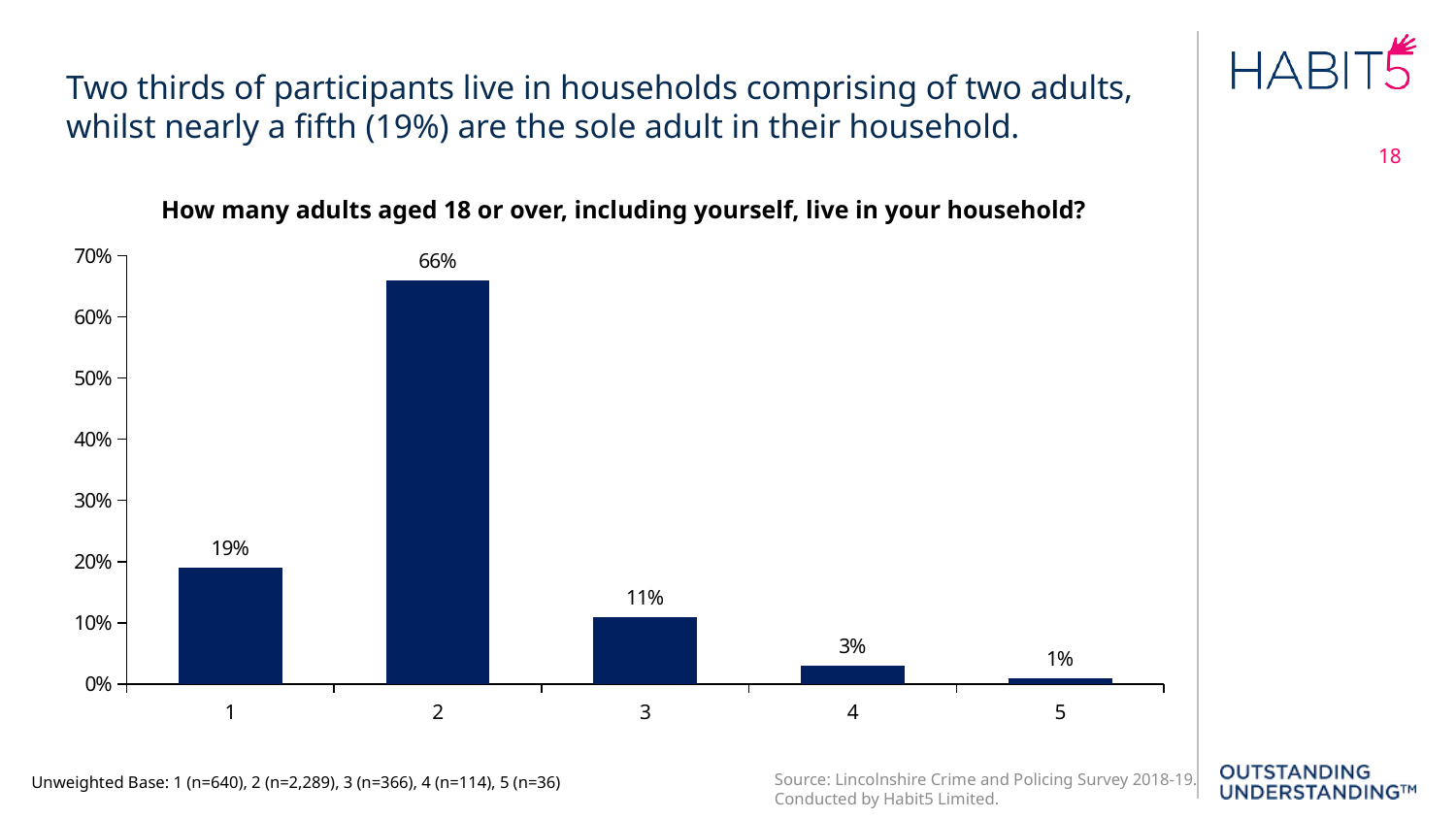
What percentage of participants live in a household with 2 adults? 66% What is the value shown for households with 5 adults? 1% What is the title of the chart? How many adults aged 18 or over, including yourself, live in your household? Which number of adults has the lowest percentage of participants? 5 What is the difference in percentage points between households with 2 adults and households with 1 adult? 47 Which number of adults has the highest percentage of participants? 2 How many categories (numbers of adults) are shown on the x axis? 5 Is the value for 2 adults greater or less than 60%? greater What kind of chart is shown on the slide? Bar chart What is the value shown for households with 3 adults? 11% What percentage of participants are the sole adult (1 adult) in their household? 19% Which is larger: the percentage for 3 adults or the percentage for 4 adults? 3 adults